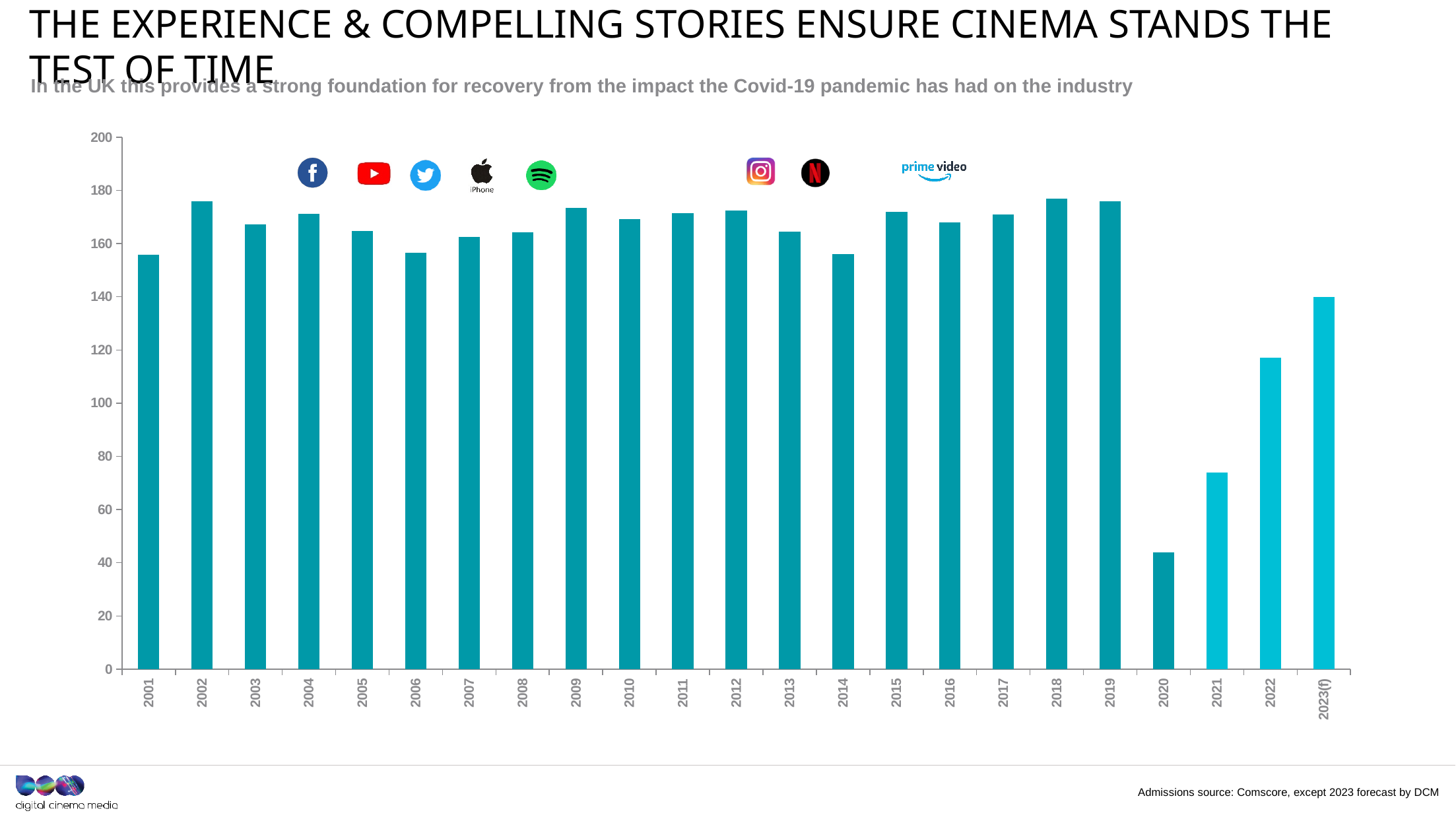
Is the value for 2023(f) greater or less than 120? greater Which is larger, the value for 2014 or the value for 2015? 2015 Is the value for 2022 greater or less than 100? greater Do the values rise or fall from 2020 to 2023(f)? rise Is the value for 2002 greater or less than 160? greater Which year has the lowest bar? 2020 Which is larger, the value for 2020 or the value for 2021? 2021 How many years (categories) are plotted on the x axis? 23 What kind of chart is shown on the slide? bar chart What is the highest value shown on the y axis? 200